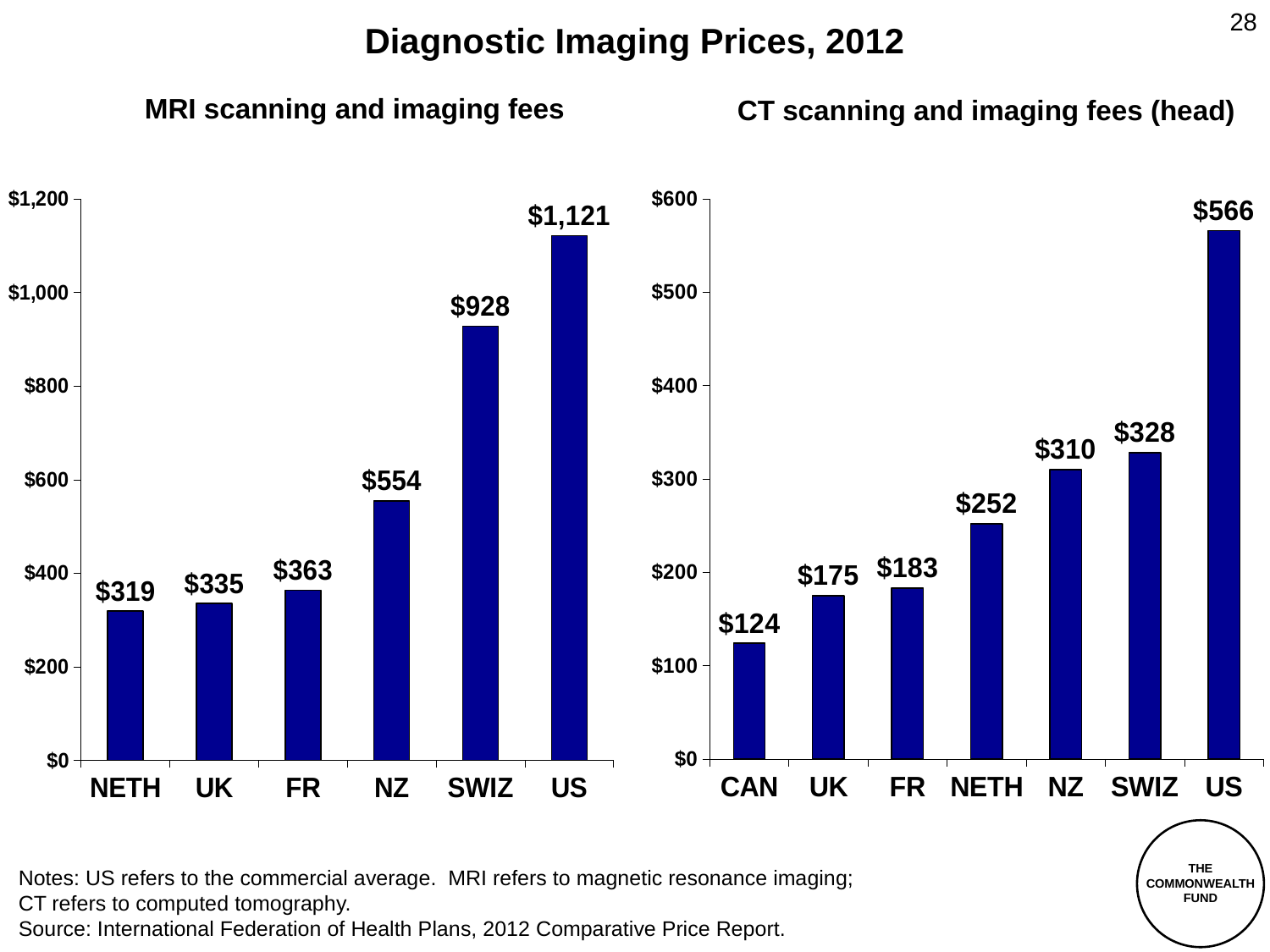
In the CT scanning and imaging fees (head) chart, which country has the lowest value? CAN In the MRI scanning and imaging fees chart, what is the difference between the US and SWIZ values? $193 How many countries are shown in the CT scanning and imaging fees (head) chart? 7 In the CT scanning and imaging fees (head) chart, what is the value for CAN? $124 In the CT scanning and imaging fees (head) chart, what is the difference between the NZ and UK values? $135 In the CT scanning and imaging fees (head) chart, is the value for NETH greater or less than $300? less In the CT scanning and imaging fees (head) chart, do the values rise or fall from left to right? Rise In the MRI scanning and imaging fees chart, which country has the highest value? US In the MRI scanning and imaging fees chart, which is larger, the value for NZ or the value for FR? NZ What kind of chart is the MRI scanning and imaging fees chart? Bar chart How many countries are shown in the MRI scanning and imaging fees chart? 6 In the MRI scanning and imaging fees chart, what is the value for SWIZ? $928